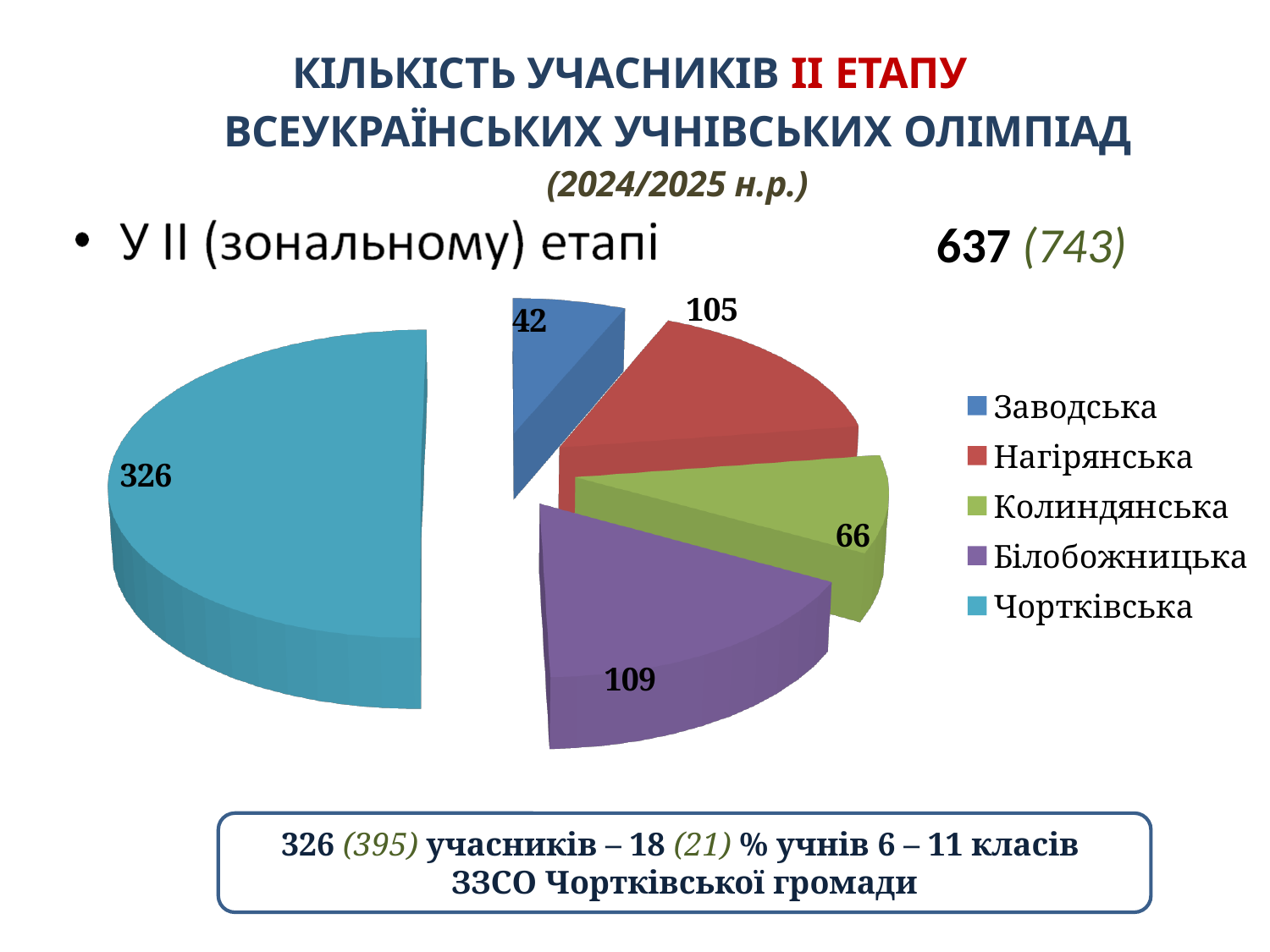
What is the value for Заводська in the pie chart? 42 What is the value for Чортківська in the pie chart? 326 What is the difference between the values for Чортківська and Білобожницька? 217 Which category has the smallest slice in the pie chart? Заводська How many slices does the pie chart have? 5 What is the value for Білобожницька in the pie chart? 109 Which category has the largest slice in the pie chart? Чортківська What is the value for Нагірянська in the pie chart? 105 What colour is the Колиндянська slice in the pie chart? green Which is larger, the value for Колиндянська or the value for Нагірянська? Нагірянська How many entries does the legend of the pie chart list? 5 What kind of chart is shown on the slide? pie chart